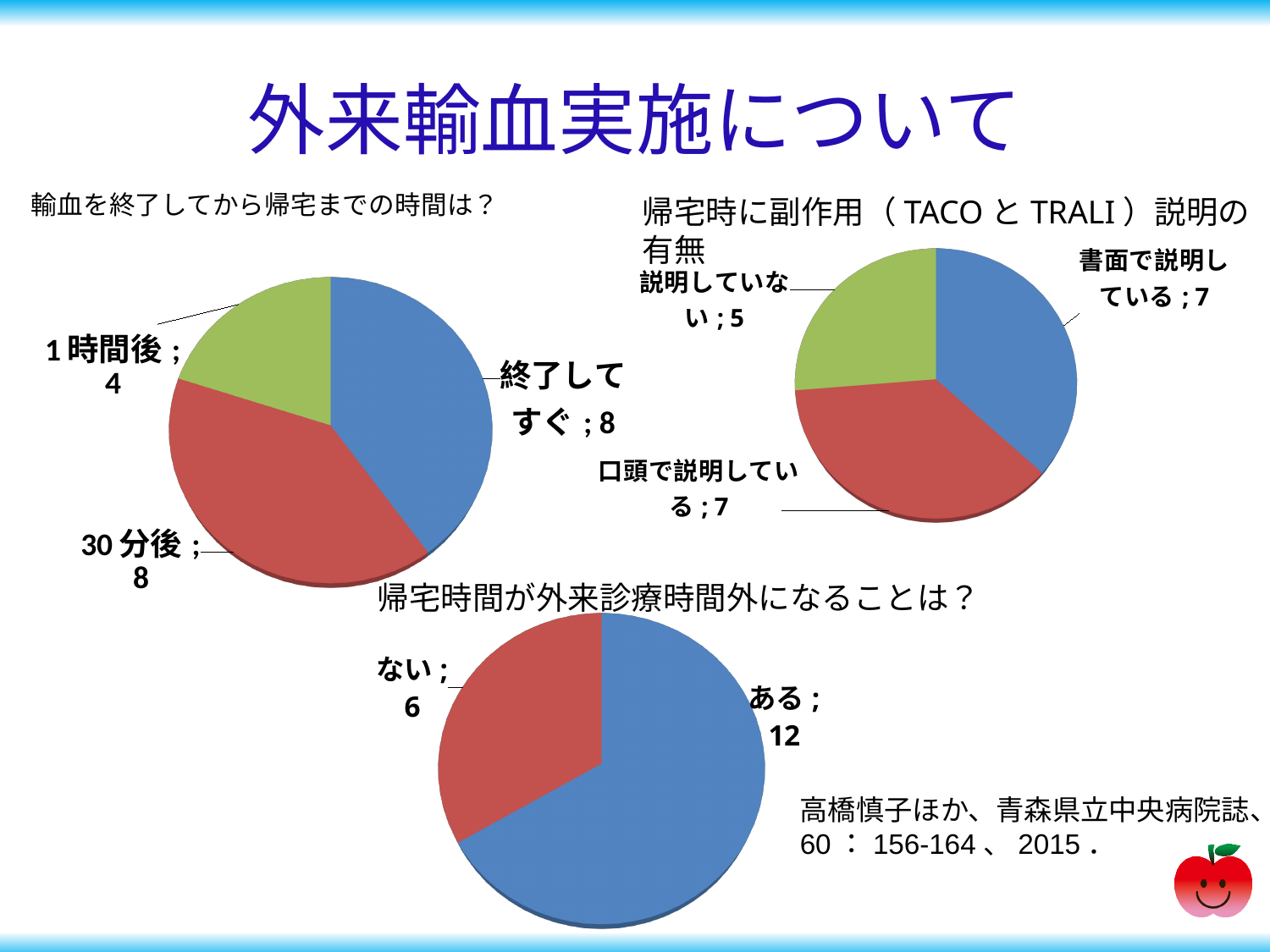
In the chart titled 「輸血を終了してから帰宅までの時間は？」, what share of the pie does 「1時間後」 represent? 20% In the chart titled 「帰宅時間が外来診療時間外になることは？」, what is the value for 「ない」? 6 In the chart titled 「帰宅時に副作用（TACOとTRALI）説明の有無」, what is the difference between 「書面で説明している」 and 「説明していない」? 2 How many slices does the chart titled 「輸血を終了してから帰宅までの時間は？」 have? 3 In the chart titled 「輸血を終了してから帰宅までの時間は？」, which is larger: 「終了してすぐ」 or 「1時間後」? 終了してすぐ In the chart titled 「帰宅時に副作用（TACOとTRALI）説明の有無」, which category has the smallest value? 説明していない In the chart titled 「輸血を終了してから帰宅までの時間は？」, which category has the smallest value? 1時間後 In the chart titled 「帰宅時に副作用（TACOとTRALI）説明の有無」, what is the value for 「説明していない」? 5 What kind of chart is the chart titled 「帰宅時間が外来診療時間外になることは？」? Pie chart In the chart titled 「輸血を終了してから帰宅までの時間は？」, what is the value for 「終了してすぐ」? 8 In the chart titled 「帰宅時間が外来診療時間外になることは？」, what is the difference between 「ある」 and 「ない」? 6 In the chart titled 「帰宅時間が外来診療時間外になることは？」, which category has the largest value? ある